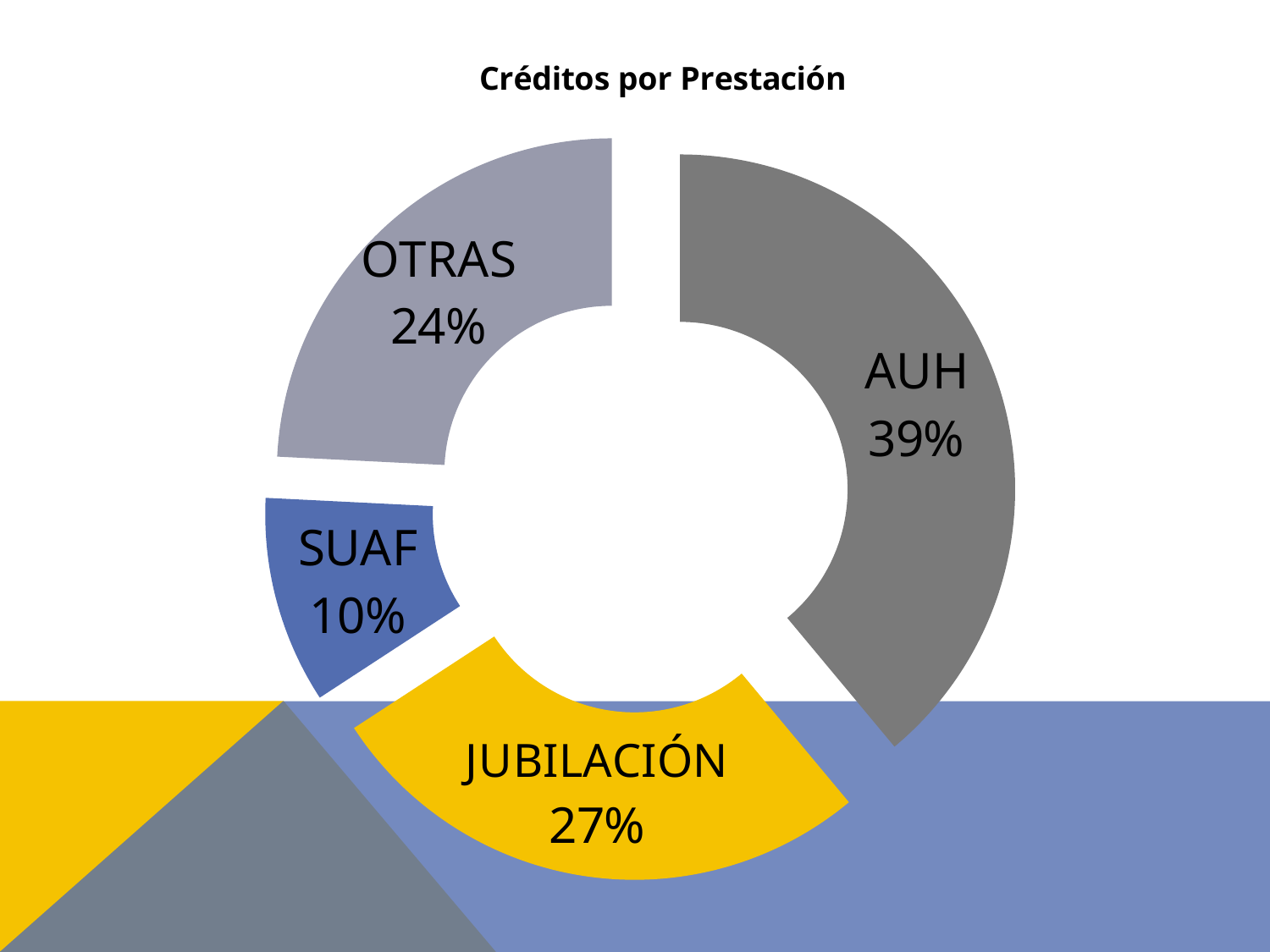
Which category has the largest share? AUH What is the title of the chart? Créditos por Prestación What percentage does AUH represent? 39% What type of chart is shown on the slide? Doughnut chart What percentage does SUAF represent? 10% What colour is the JUBILACIÓN segment? Yellow What percentage does OTRAS represent? 24% What is the difference in percentage points between AUH and JUBILACIÓN? 12 Which is larger, OTRAS or JUBILACIÓN? JUBILACIÓN Which category has the smallest share? SUAF What percentage does JUBILACIÓN represent? 27% How many categories are shown in the chart? 4